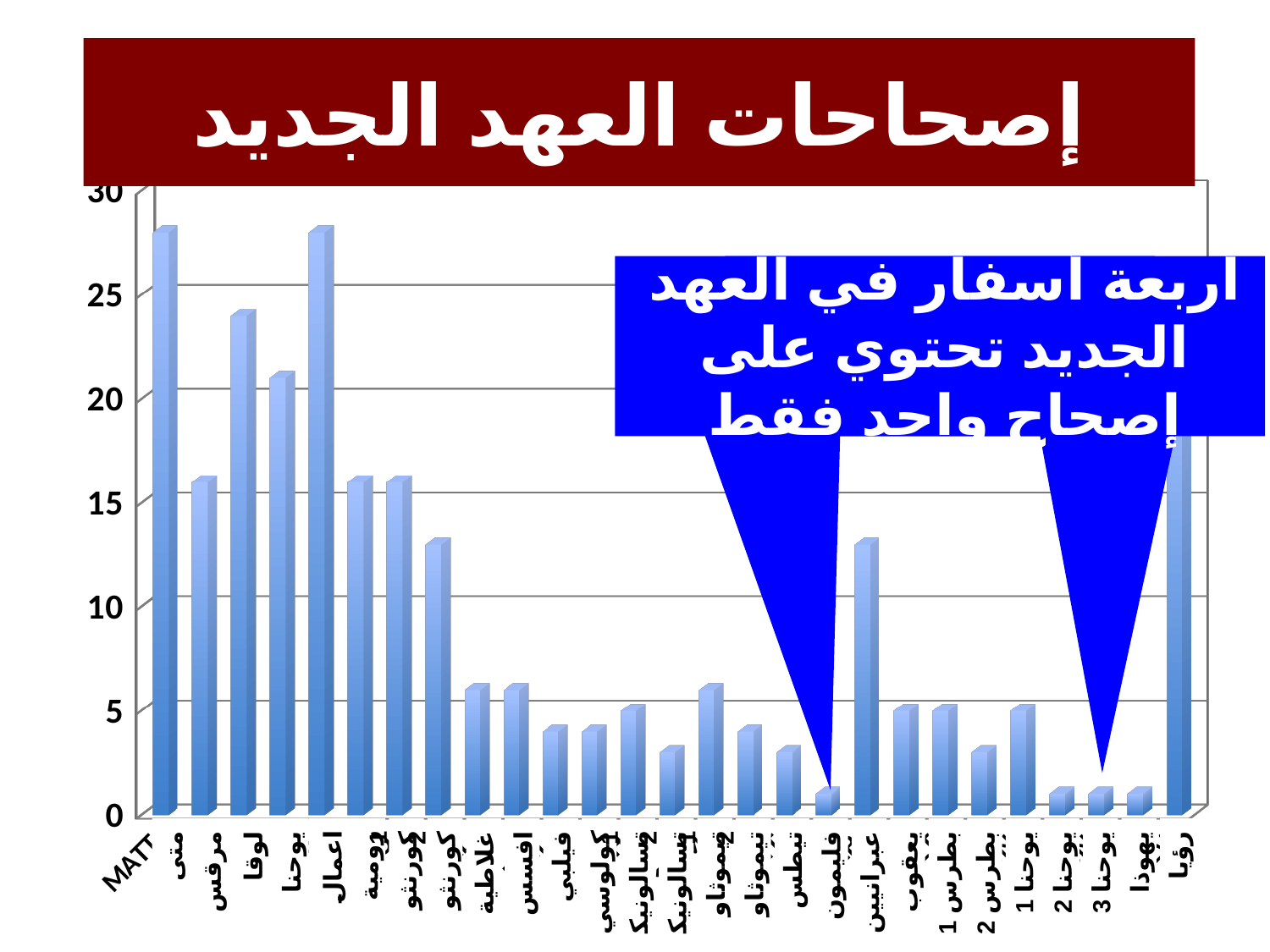
Is the value for لوقا greater or less than 20? greater Which has the larger value, لوقا or مرقس? لوقا Is the value for متى greater or less than 25? greater Is the value for فليمون greater or less than 5? less Which has the larger value, عبرانيين or يعقوب? عبرانيين What is the title of the chart on the slide? إصحاحات العهد الجديد Which has the larger value, رؤيا or عبرانيين? رؤيا What is the highest value shown on the vertical axis of the chart? 30 What kind of chart is shown on the slide? bar chart